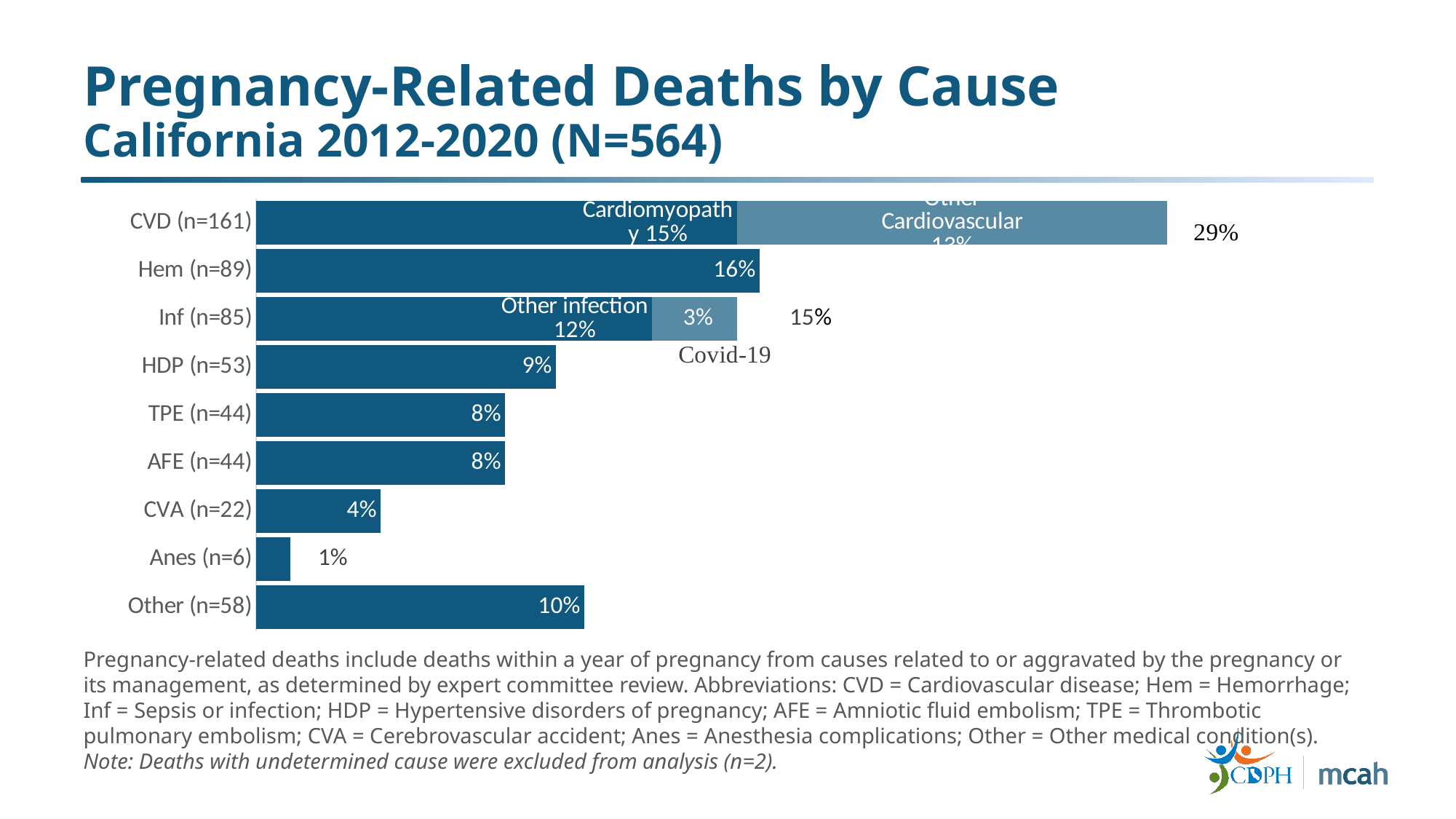
Which has a larger percentage, Other (n=58) or HDP (n=53)? Other (n=58) What percentage is shown for HDP (n=53)? 9% What is the total percentage shown for the CVD (n=161) bar? 29% How many cause categories are shown on the chart? 9 Which cause category has the lowest percentage of pregnancy-related deaths? Anes (n=6) Which cause category has the highest percentage of pregnancy-related deaths? CVD (n=161) What type of chart is shown on the slide? Bar chart What is the difference in percentage points between Hem (n=89) and CVA (n=22)? 12 What percentage of pregnancy-related deaths is shown for Hem (n=89)? 16% What percentage is shown for the Cardiomyopathy segment of the CVD bar? 15% What percentage is shown for the Covid-19 segment of the Inf (n=85) bar? 3% What is the title of the chart on the slide? Pregnancy-Related Deaths by Cause California 2012-2020 (N=564)